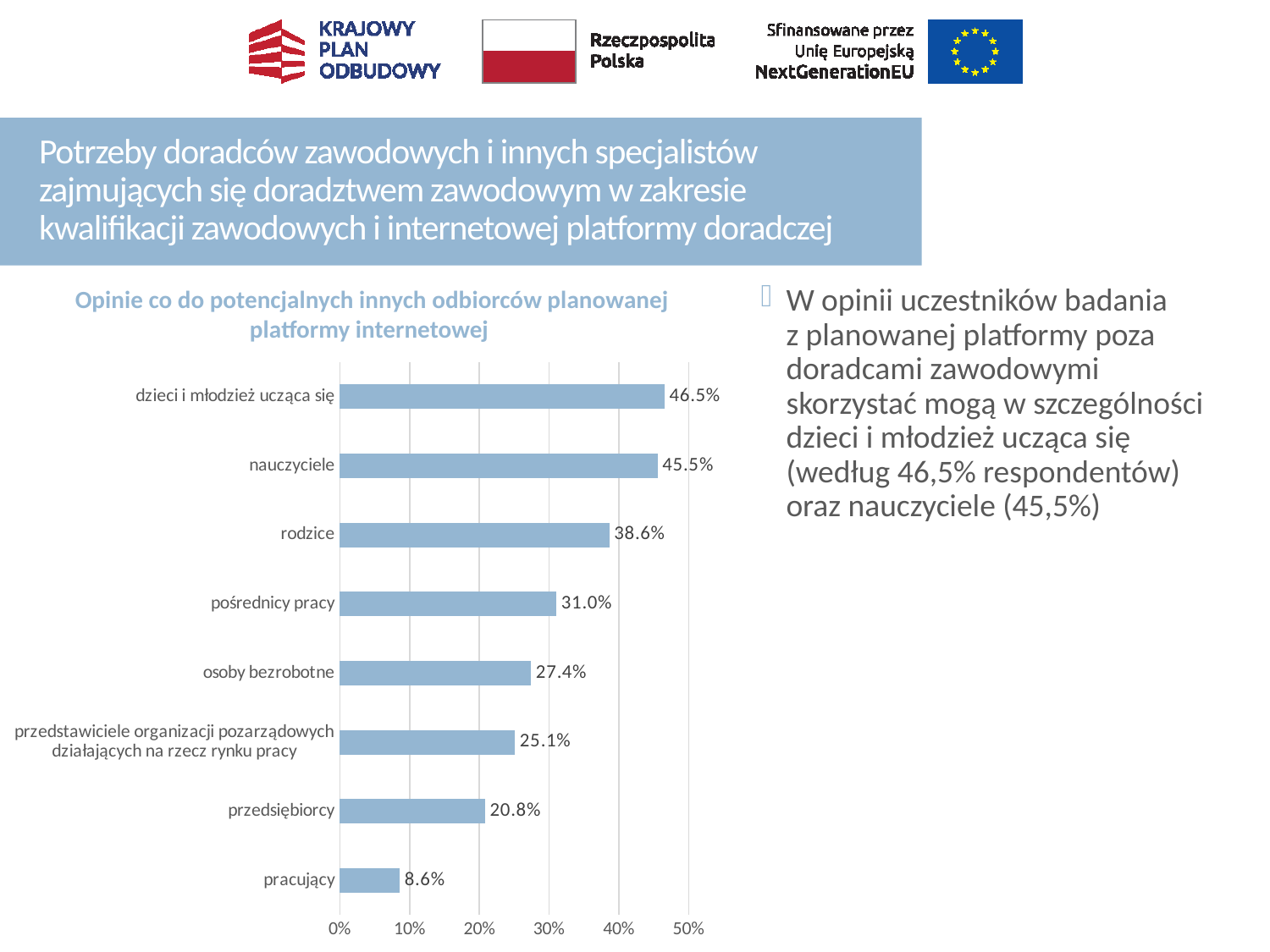
Which is larger, the value for "przedsiębiorcy" or the value for "osoby bezrobotne"? osoby bezrobotne What is the value for "nauczyciele"? 45.5% Which category has the highest value? dzieci i młodzież ucząca się What is the difference between the values for "dzieci i młodzież ucząca się" and "nauczyciele"? 1.0% What kind of chart is shown on the slide? bar chart What is the value for "przedstawiciele organizacji pozarządowych działających na rzecz rynku pracy"? 25.1% What is the value for "rodzice"? 38.6% Which category has the lowest value? pracujący What is the title of the chart? Opinie co do potencjalnych innych odbiorców planowanej platformy internetowej What is the value for "pracujący"? 8.6% How many categories are shown in the chart? 8 What is the difference between the values for "pośrednicy pracy" and "osoby bezrobotne"? 3.6%